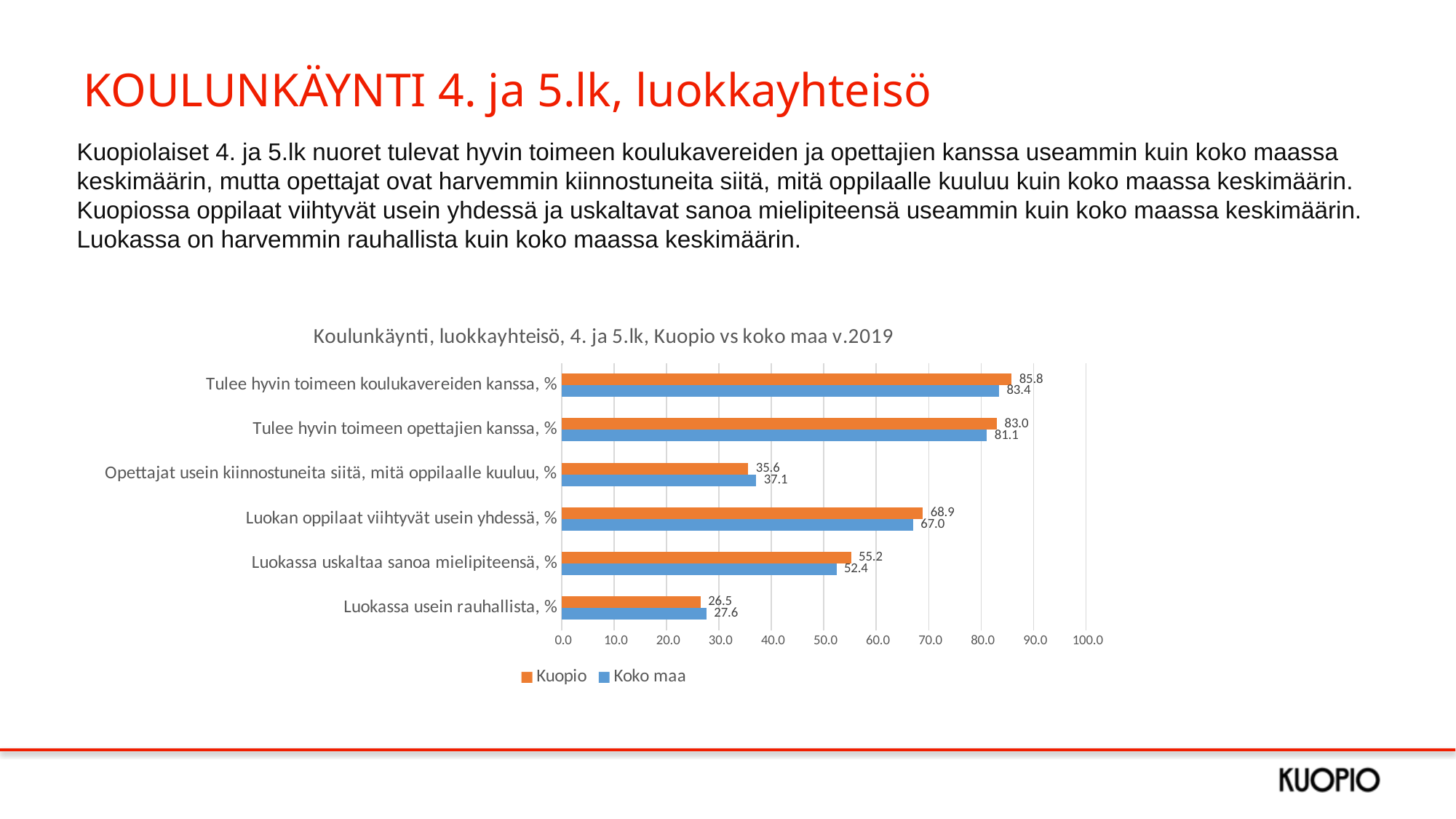
Is the Kuopio value for "Luokan oppilaat viihtyvät usein yhdessä, %" greater or less than 60.0? greater What is the title of the chart? Koulunkäynti, luokkayhteisö, 4. ja 5.lk, Kuopio vs koko maa v.2019 How many series does the legend list? 2 For "Luokassa usein rauhallista, %", which is larger: the Kuopio value or the Koko maa value? Koko maa What is the Kuopio value for "Opettajat usein kiinnostuneita siitä, mitä oppilaalle kuuluu, %"? 35.6 Which category has the lowest Kuopio value? Luokassa usein rauhallista, % What kind of chart is shown on the slide? Bar chart Which category has the highest Koko maa value? Tulee hyvin toimeen koulukavereiden kanssa, % What is the Koko maa value for "Luokassa uskaltaa sanoa mielipiteensä, %"? 52.4 How many categories are shown on the chart? 6 What is the Kuopio value for "Tulee hyvin toimeen koulukavereiden kanssa, %"? 85.8 What is the difference between the Kuopio and Koko maa values for "Luokassa uskaltaa sanoa mielipiteensä, %"? 2.8